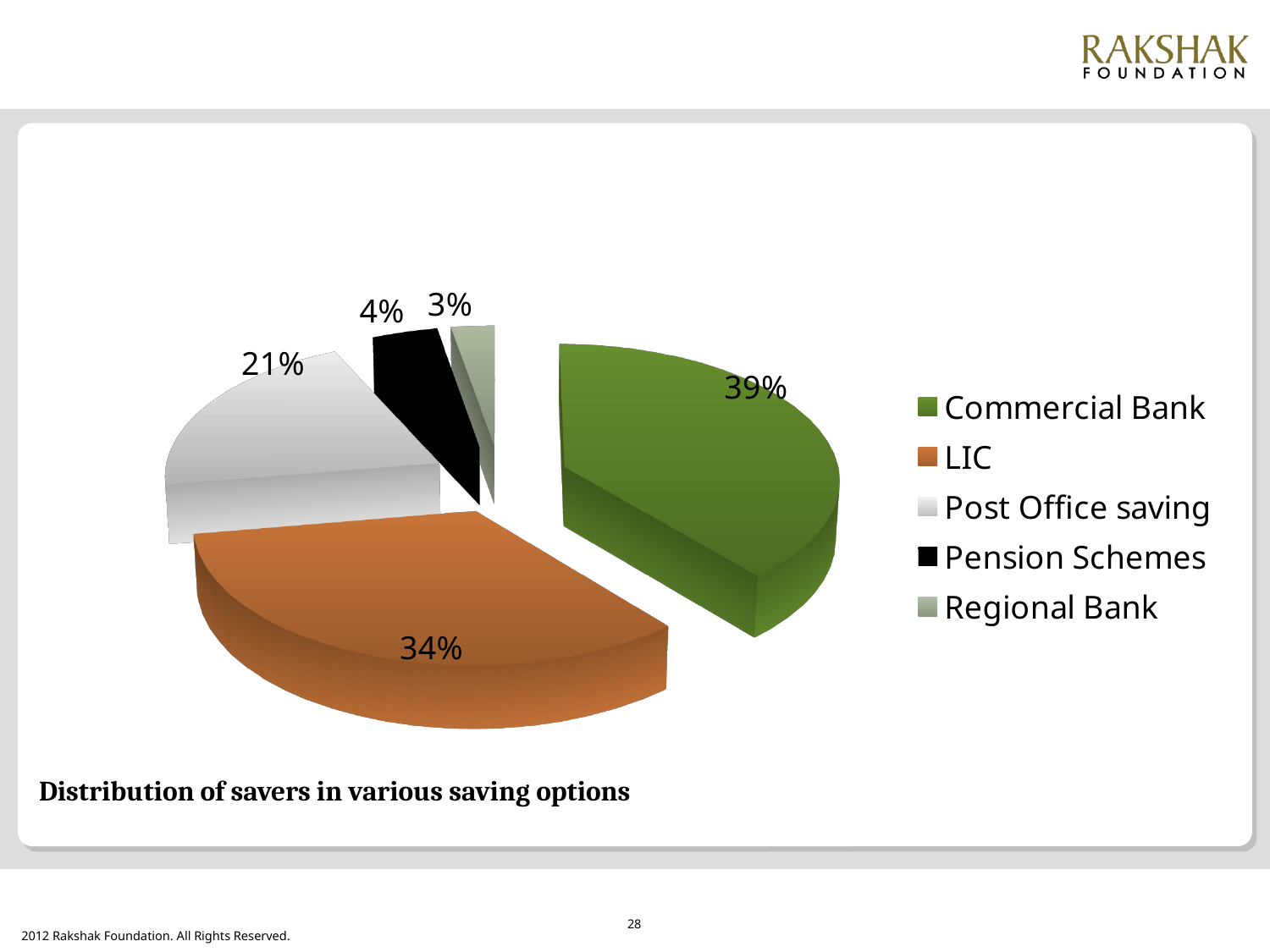
Which saving option has the smallest share of savers? Regional Bank What share of savers use Commercial Bank? 39% What share of savers use Pension Schemes? 4% What share of savers use LIC? 34% What is the difference in percentage points between Commercial Bank and LIC? 5 Which has a larger share, Post Office saving or Pension Schemes? Post Office saving What is the caption below the chart? Distribution of savers in various saving options What kind of chart is shown on the slide? pie chart What share of savers use Post Office saving? 21% Which saving option has the largest share of savers? Commercial Bank What share of savers use Regional Bank? 3% How many saving options are shown in the pie chart? 5